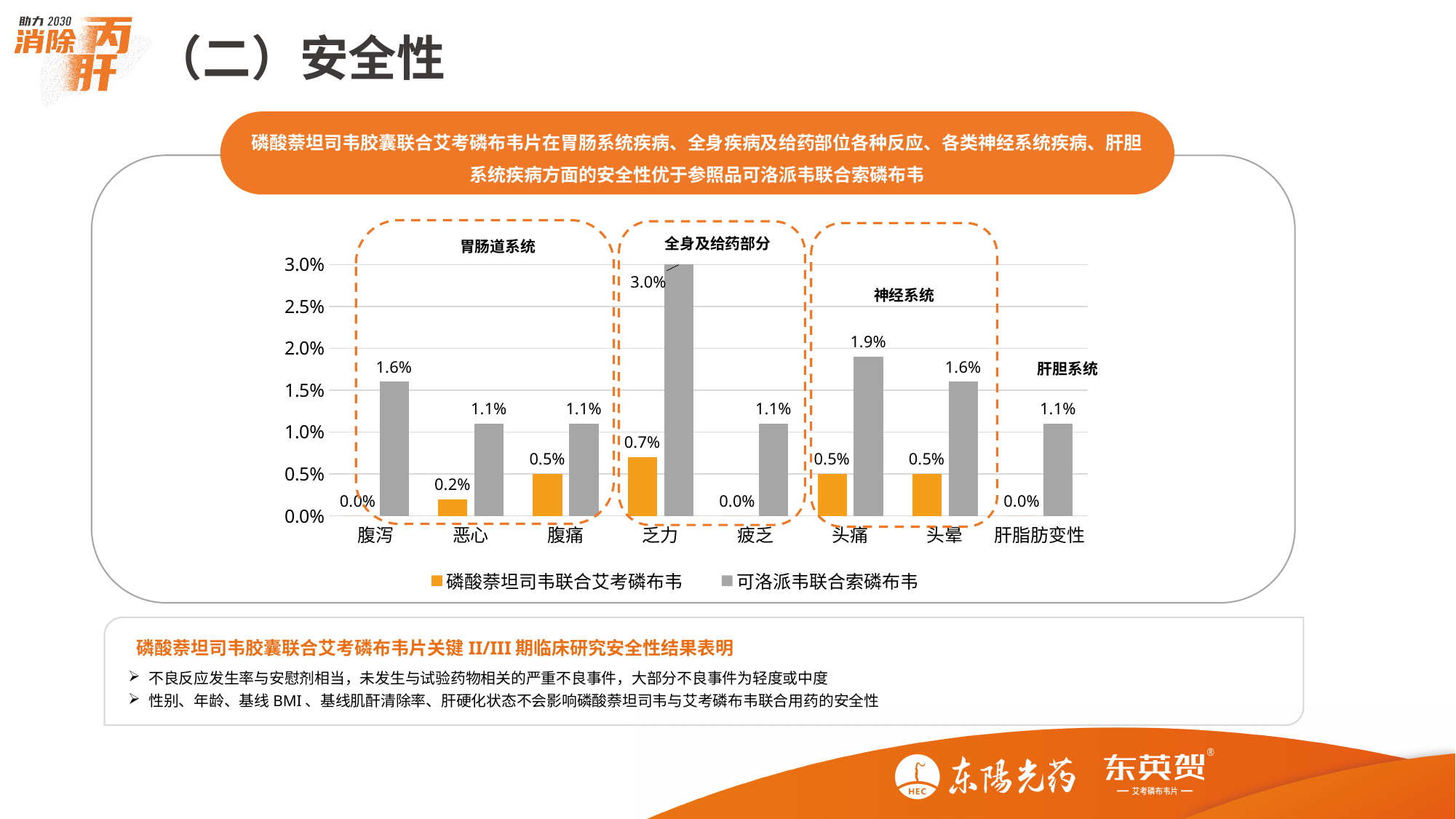
Which category has the highest value for 可洛派韦联合索磷布韦? 乏力 What is the value for 可洛派韦联合索磷布韦 in the 乏力 category? 3.0% In the 腹泻 category, which series has the larger value, 磷酸萘坦司韦联合艾考磷布韦 or 可洛派韦联合索磷布韦? 可洛派韦联合索磷布韦 How many categories are shown on the x axis of the chart? 8 Which colour represents 可洛派韦联合索磷布韦 in the chart? Gray What is the value for 磷酸萘坦司韦联合艾考磷布韦 in the 恶心 category? 0.2% How many series does the chart legend list? 2 What is the difference between the 可洛派韦联合索磷布韦 and 磷酸萘坦司韦联合艾考磷布韦 values in the 头晕 category? 1.1% What kind of chart is shown on the slide? Bar chart What is the value for 可洛派韦联合索磷布韦 in the 头痛 category? 1.9% Which category has the highest value for 磷酸萘坦司韦联合艾考磷布韦? 乏力 What is the value for 磷酸萘坦司韦联合艾考磷布韦 in the 肝脂肪变性 category? 0.0%